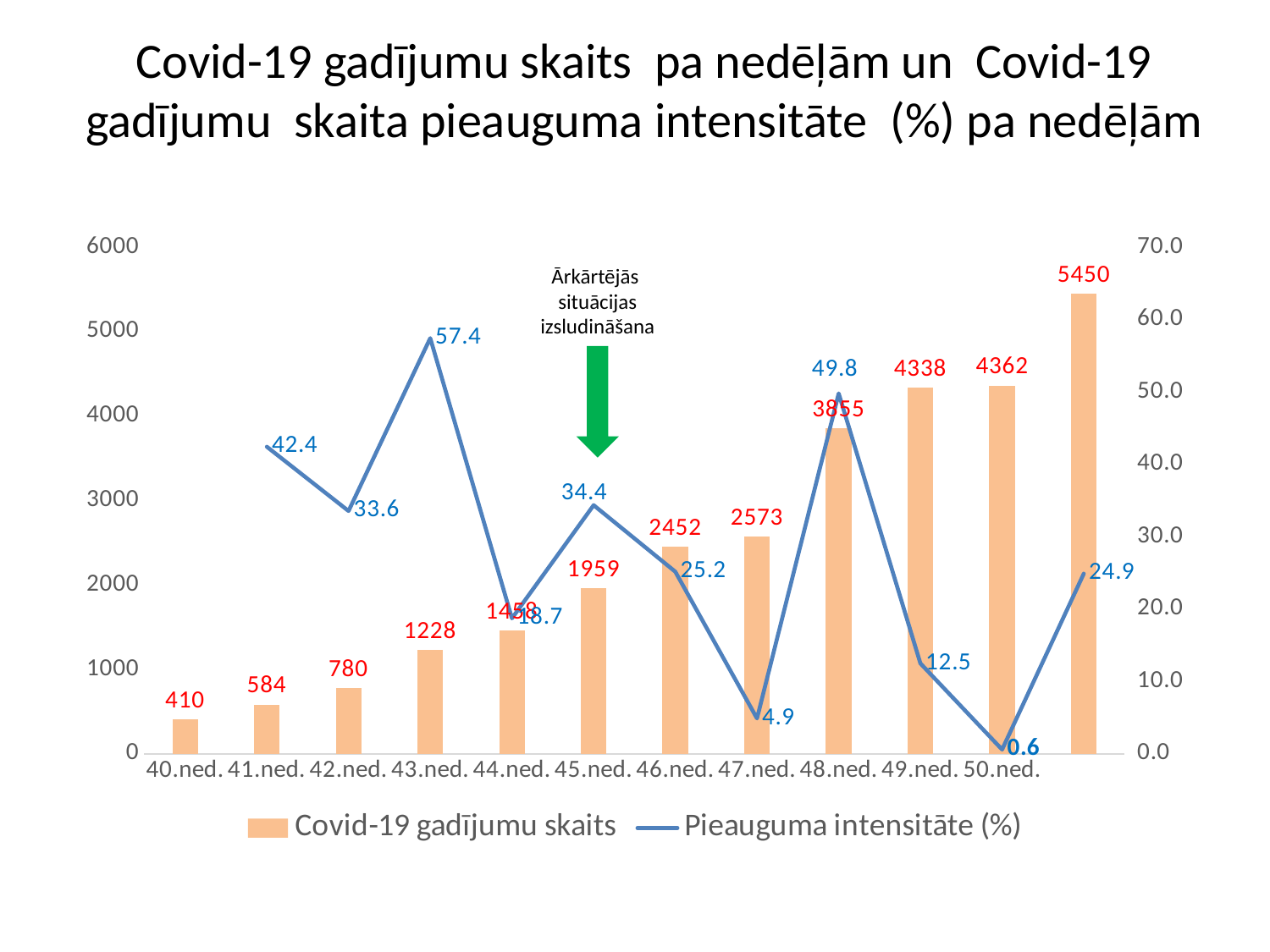
Which week has the lowest Covid-19 gadījumu skaits? 40.ned. What is the difference in Covid-19 gadījumu skaits between 49.ned. and 48.ned.? 483 What is the Covid-19 gadījumu skaits value for 43.ned.? 1228 In which week does Pieauguma intensitāte (%) reach its highest value? 43.ned. In which week is Pieauguma intensitāte (%) lowest? 50.ned. What is the Pieauguma intensitāte (%) value for 48.ned.? 49.8 What is the Covid-19 gadījumu skaits value for 47.ned.? 2573 What is the difference in Pieauguma intensitāte (%) between 43.ned. and 41.ned.? 15.0 How many series does the legend list? 2 Does Covid-19 gadījumu skaits rise or fall from 40.ned. to 50.ned.? Rise Which week has a higher Covid-19 gadījumu skaits, 45.ned. or 46.ned.? 46.ned. What kind of chart is shown on the slide? Combined bar and line chart